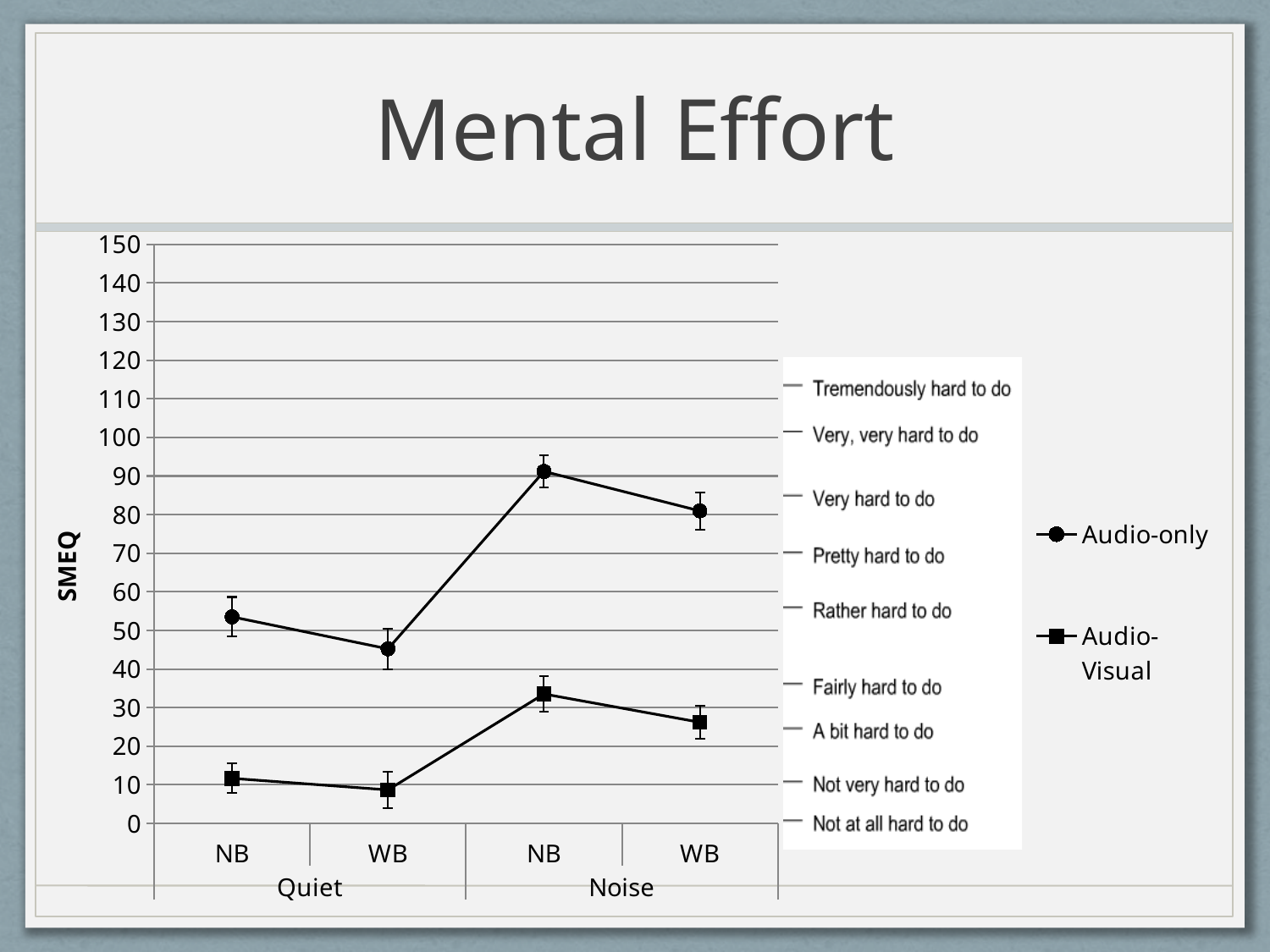
Is the Audio-Visual value for Quiet NB greater or less than 20? less How many data points does the Audio-only series have? 4 For the Audio-only series, which condition has the highest SMEQ value? Noise NB At Noise NB, which series has the larger SMEQ value, Audio-only or Audio-Visual? Audio-only How many series does the legend list? 2 For the Audio-Visual series, which condition has the highest SMEQ value? Noise NB For the Audio-only series, which condition has the lowest SMEQ value? Quiet WB Is the Audio-only value for Noise NB greater or less than 80? greater What kind of chart is shown on the slide? line chart Is the Audio-only value for Quiet WB greater or less than 50? less What is the label on the vertical axis? SMEQ Does the Audio-only series rise or fall from Noise NB to Noise WB? fall